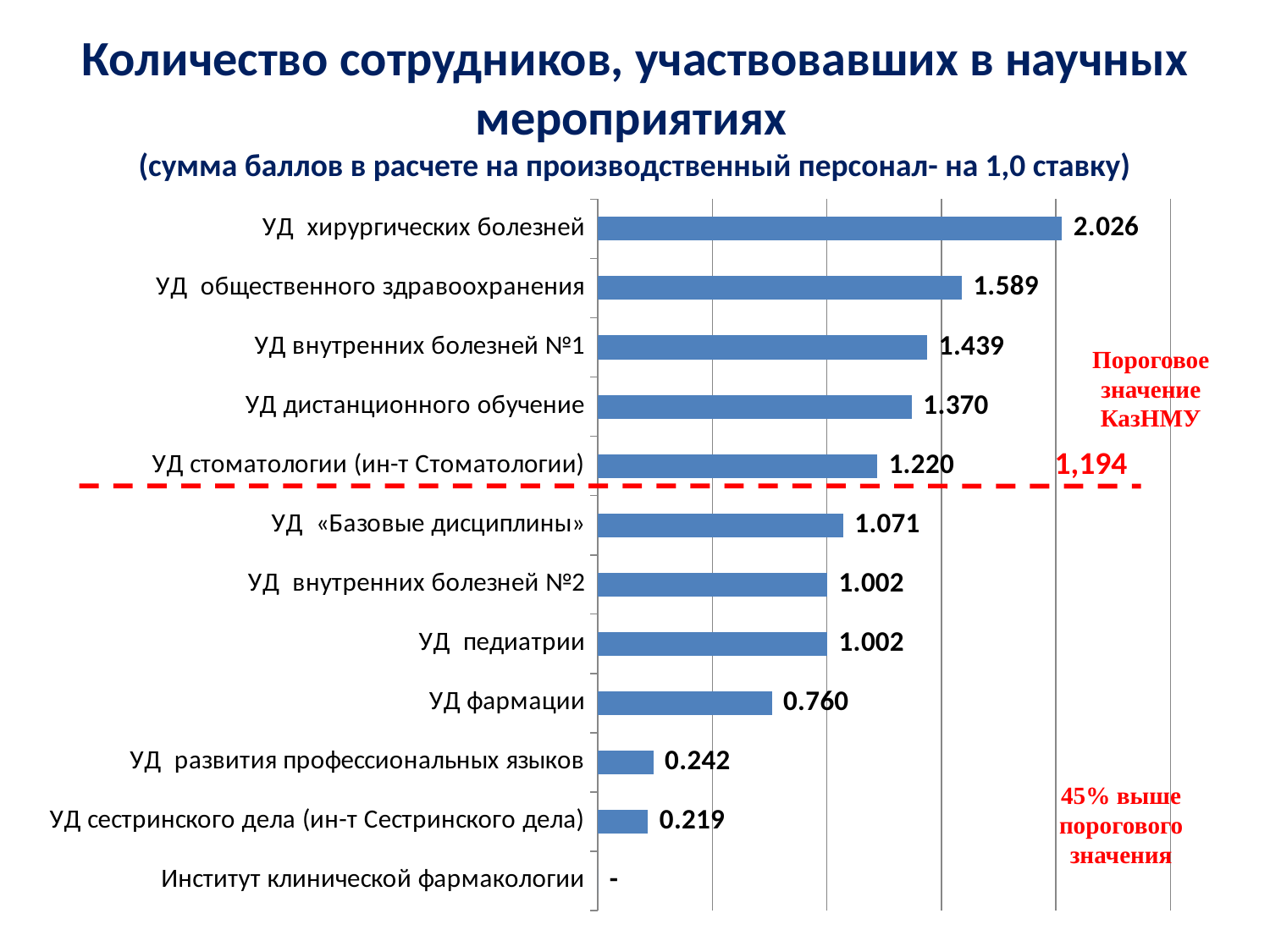
How many categories are listed on the chart? 12 Which category has the highest value? УД хирургических болезней What type of chart is shown on the slide? bar chart What is the difference between the values for УД развития профессиональных языков and УД сестринского дела (ин-т Сестринского дела)? 0.023 What is the value for УД дистанционного обучение? 1.370 What is the difference between the values for УД хирургических болезней and УД общественного здравоохранения? 0.437 Which category with a plotted bar has the lowest value? УД сестринского дела (ин-т Сестринского дела) Which is larger, the value for УД стоматологии (ин-т Стоматологии) or the value for УД «Базовые дисциплины»? УД стоматологии (ин-т Стоматологии) What is the value for УД хирургических болезней? 2.026 What is the value for УД фармации? 0.760 What threshold value (Пороговое значение КазНМУ) is marked by the red dashed line? 1,194 What is the value for УД сестринского дела (ин-т Сестринского дела)? 0.219